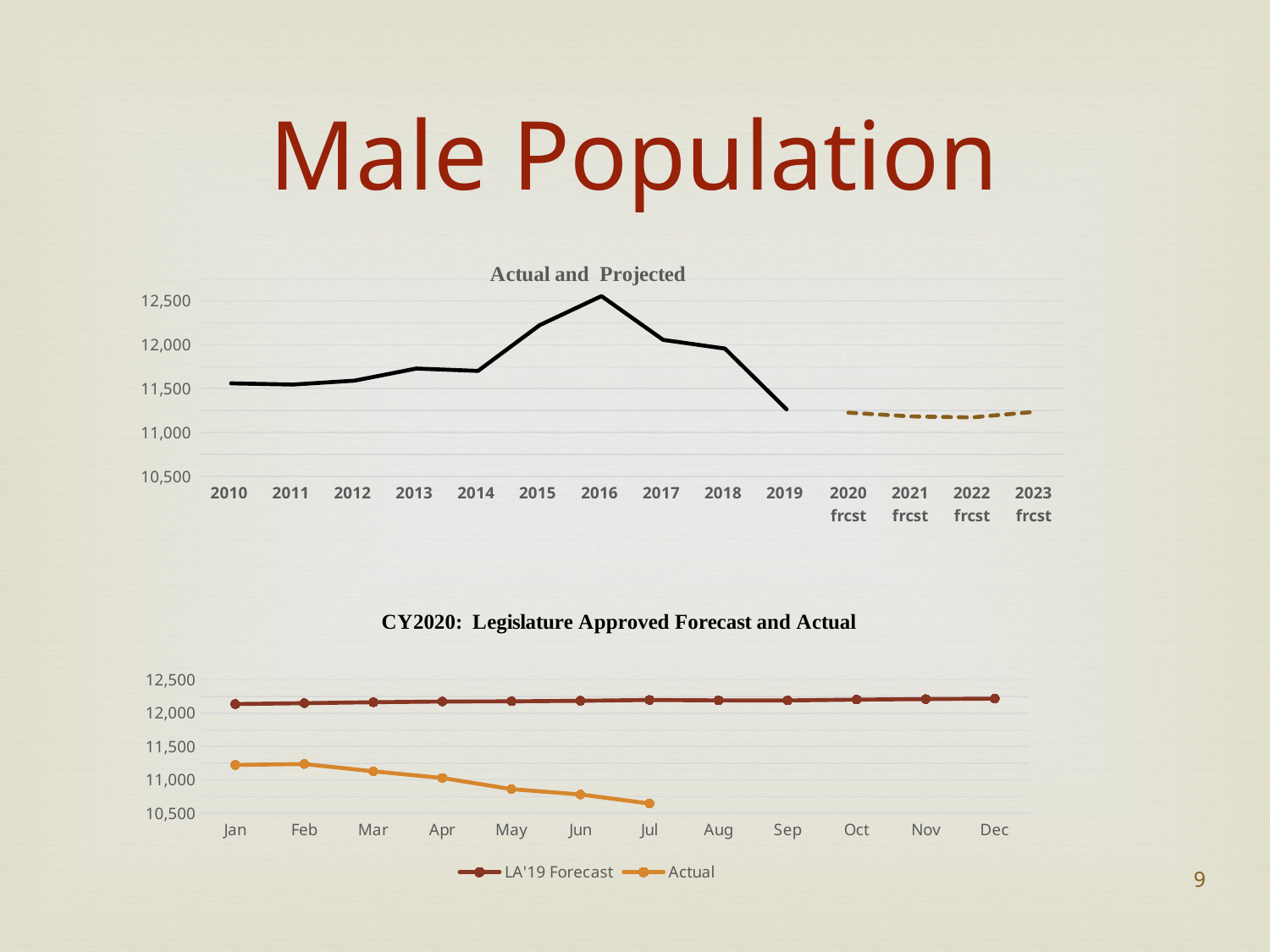
What kind of chart is the top chart titled "Actual and Projected"? line chart In the top chart titled "Actual and Projected", which year has the highest male population? 2016 In the bottom chart titled "CY2020: Legislature Approved Forecast and Actual", do the Actual values rise or fall from Jan to Jul? fall In the bottom chart titled "CY2020: Legislature Approved Forecast and Actual", what are the two series named in the legend? LA'19 Forecast and Actual In the bottom chart titled "CY2020: Legislature Approved Forecast and Actual", how many series does the legend list? 2 In the top chart titled "Actual and Projected", do the values rise or fall from 2016 to 2019? fall In the top chart titled "Actual and Projected", is the value for 2019 greater or less than 11,500? less In the top chart titled "Actual and Projected", how many years are shown on the x axis? 14 In the bottom chart titled "CY2020: Legislature Approved Forecast and Actual", which series is higher in Jan, LA'19 Forecast or Actual? LA'19 Forecast In the top chart titled "Actual and Projected", is the value for 2015 greater or less than 12,000? greater In the bottom chart titled "CY2020: Legislature Approved Forecast and Actual", is the Actual value for Jul greater or less than 11,000? less